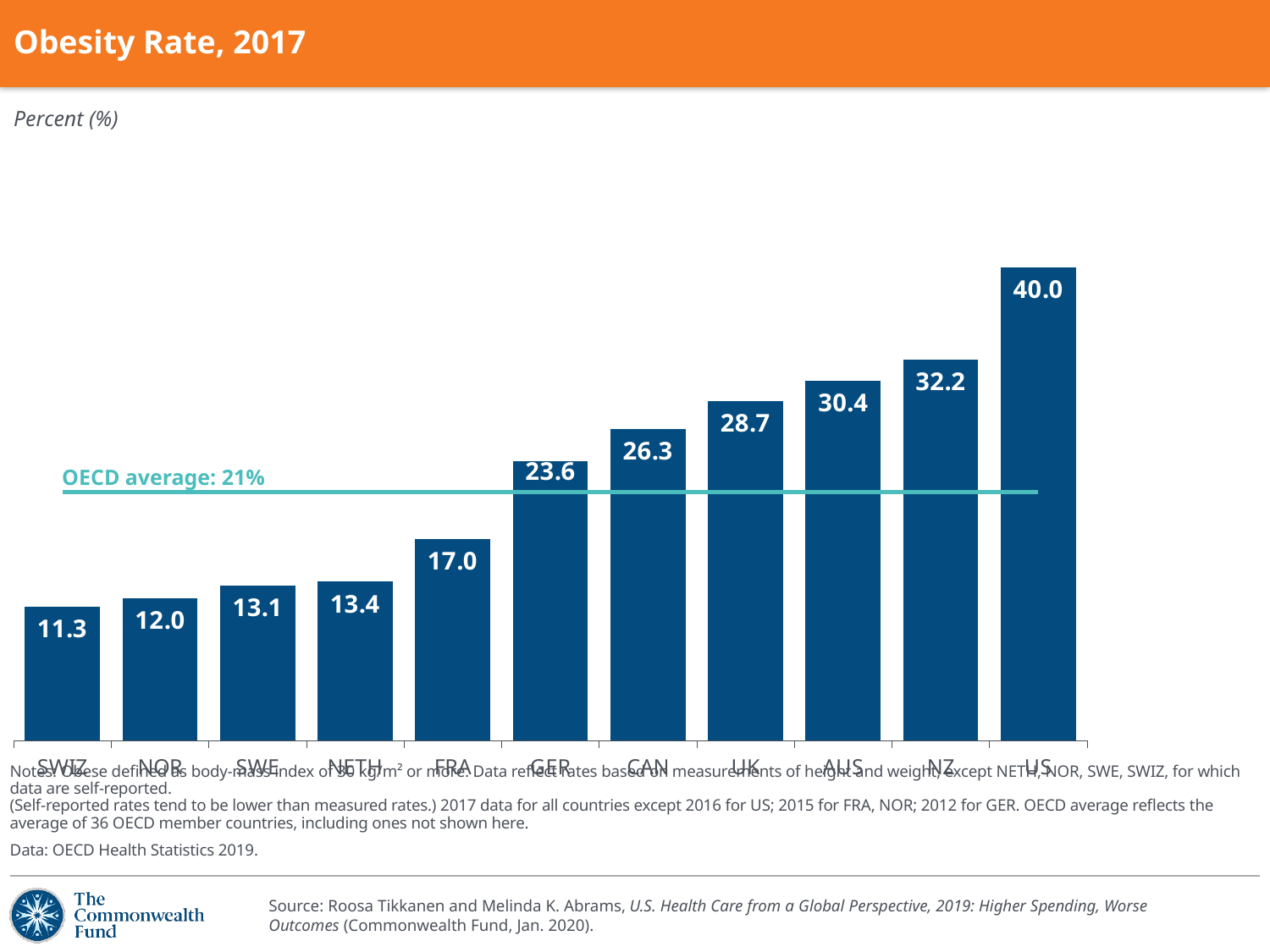
What OECD average value is marked by the horizontal line on the chart? 21% What is the obesity rate shown for FRA? 17.0 What is the obesity rate shown for the US? 40.0 How many countries are shown on the chart? 11 What type of chart is shown on the slide? Bar chart Which country has the lowest obesity rate on the chart? SWIZ What is the obesity rate shown for CAN? 26.3 Which has a higher obesity rate, AUS or UK? AUS Which country has the highest obesity rate on the chart? US What is the difference between the obesity rates of the US and NZ? 7.8 Do the obesity rates rise or fall from left to right across the chart? Rise What is the difference between the obesity rates of GER and FRA? 6.6